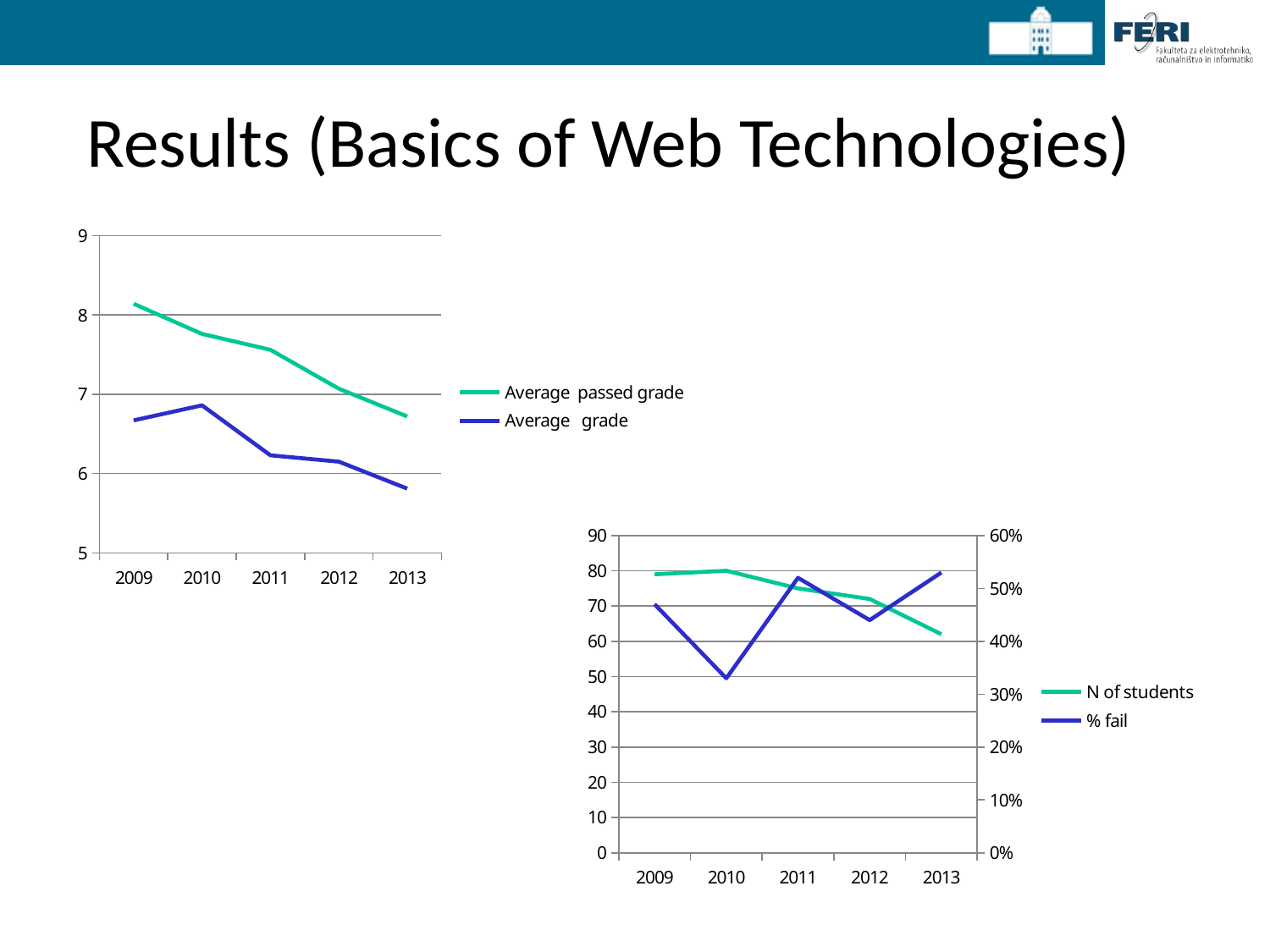
In the right chart, which year has the lowest % fail? 2010 In the left chart, is the Average passed grade for 2009 greater or less than 8? greater In the right chart, which year has the lowest N of students? 2013 In the left chart, is the Average grade for 2013 greater or less than 6? less What are the two series listed in the legend of the right chart? N of students and % fail In the left chart, which is higher in 2011, the Average passed grade or the Average grade? Average passed grade How many series does the legend of the left chart list? 2 How many years are shown on the x axis of the left chart? 5 What kind of chart is the chart on the left of the slide? line chart In the left chart, which year has the lowest Average grade? 2013 In the left chart, does the Average passed grade rise or fall from 2009 to 2013? fall In the right chart, is the % fail for 2010 greater or less than 40%? less